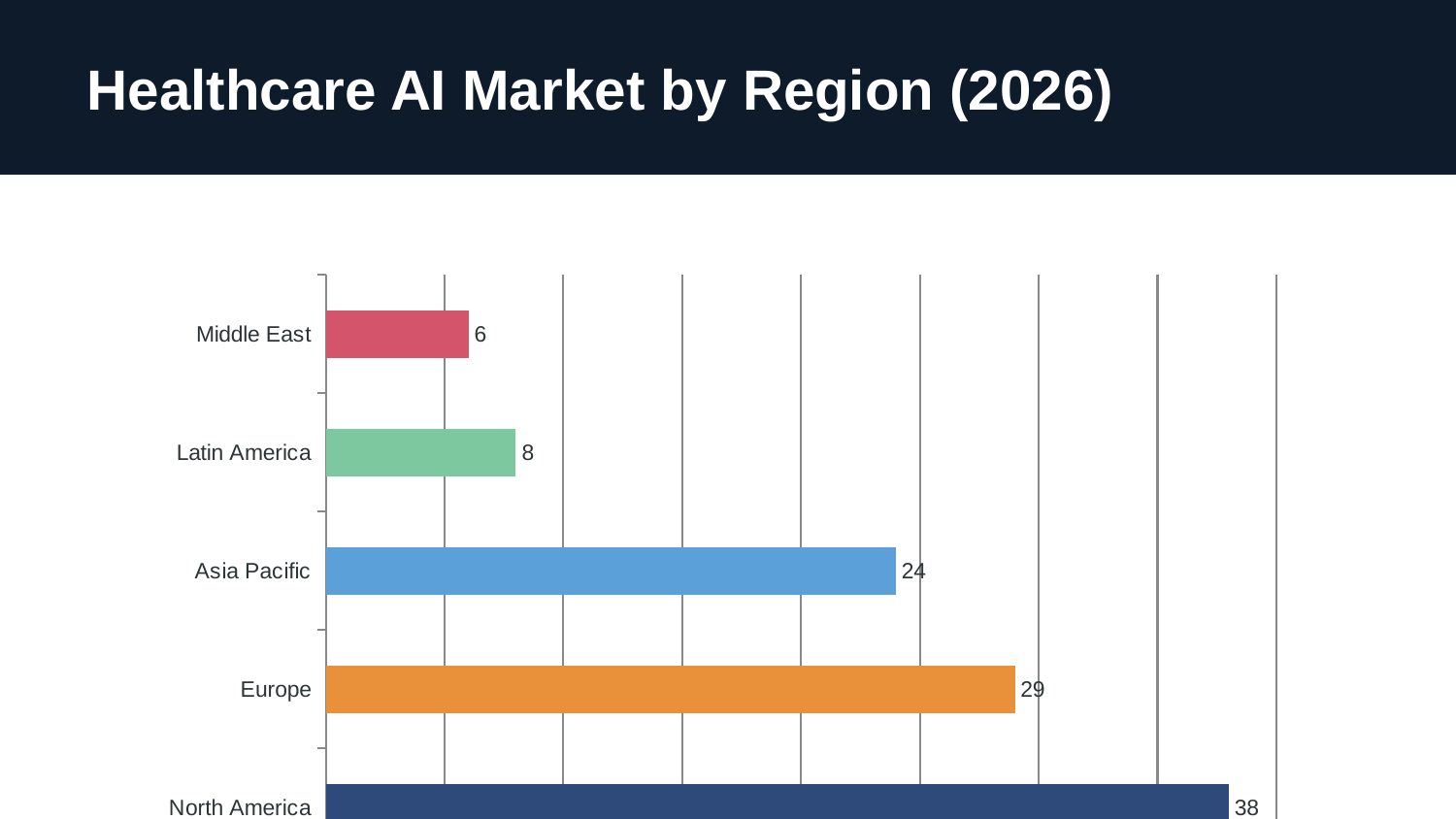
What is the title of the slide? Healthcare AI Market by Region (2026) What is the value for North America? 38 Which region has the highest value? North America What is the difference between the values for Asia Pacific and Latin America? 16 What is the value for Latin America? 8 Which region has the lowest value? Middle East What colour is the bar for Europe? Orange Which is larger, the value for Europe or the value for Asia Pacific? Europe How many regions are shown in the chart? 5 What kind of chart is shown on the slide? Bar chart What is the difference between the values for North America and Europe? 9 What is the value for Asia Pacific? 24